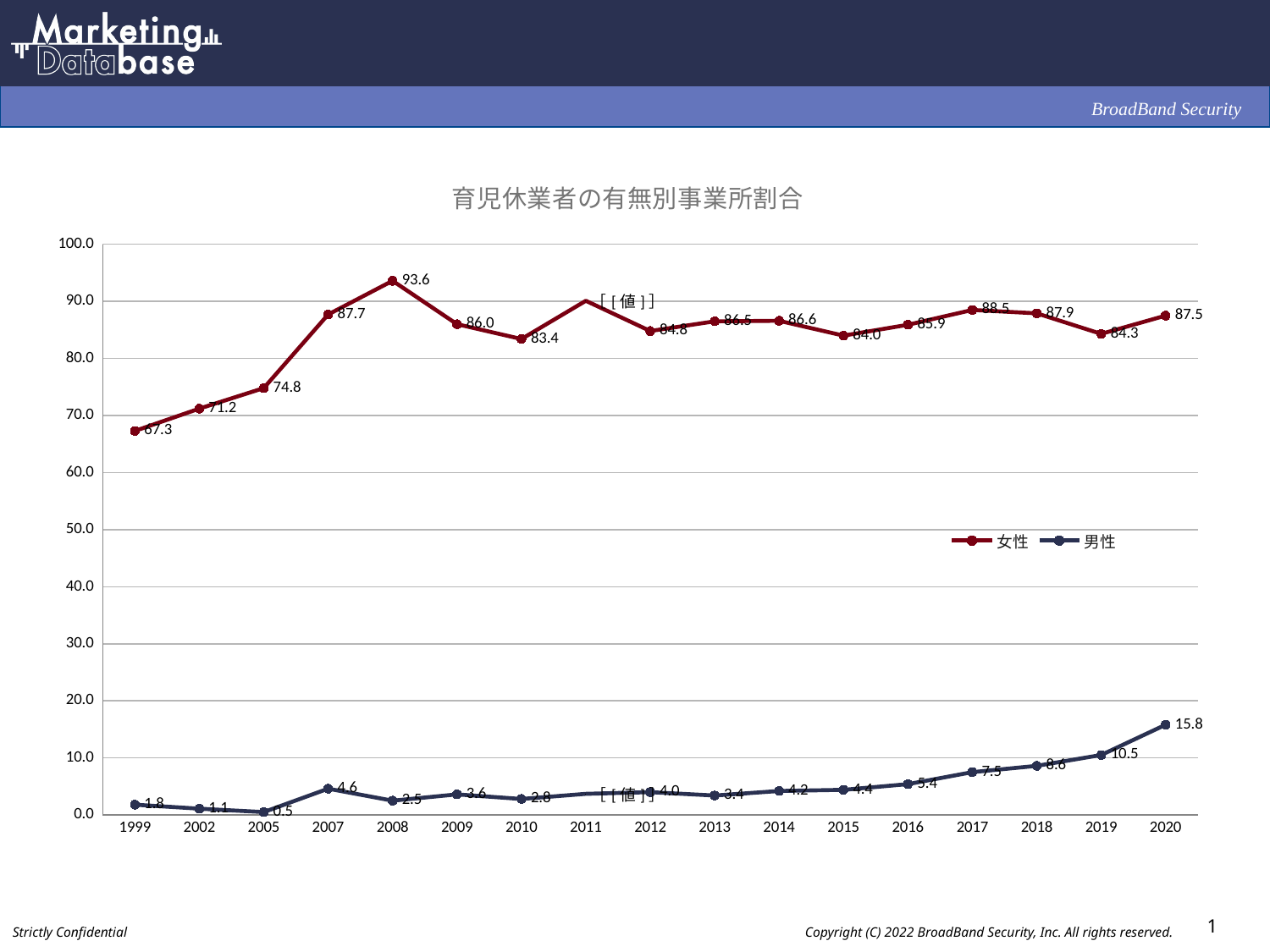
Does the 男性 series rise or fall from 2016 to 2020? rise What kind of chart is shown on the slide? line chart By how much did the 男性 value increase from 2019 to 2020? 5.3 Is the value for 女性 in 2011 greater or less than 80.0? greater What is the value for 女性 in 2008? 93.6 How many years are plotted along the x axis? 17 What is the value for 男性 in 2007? 4.6 How many series does the legend list? 2 What is the value for 男性 in 2020? 15.8 In which year is the 男性 series at its lowest? 2005 Which year has the higher 女性 value, 2007 or 2009? 2007 In which year is the 女性 series at its highest? 2008